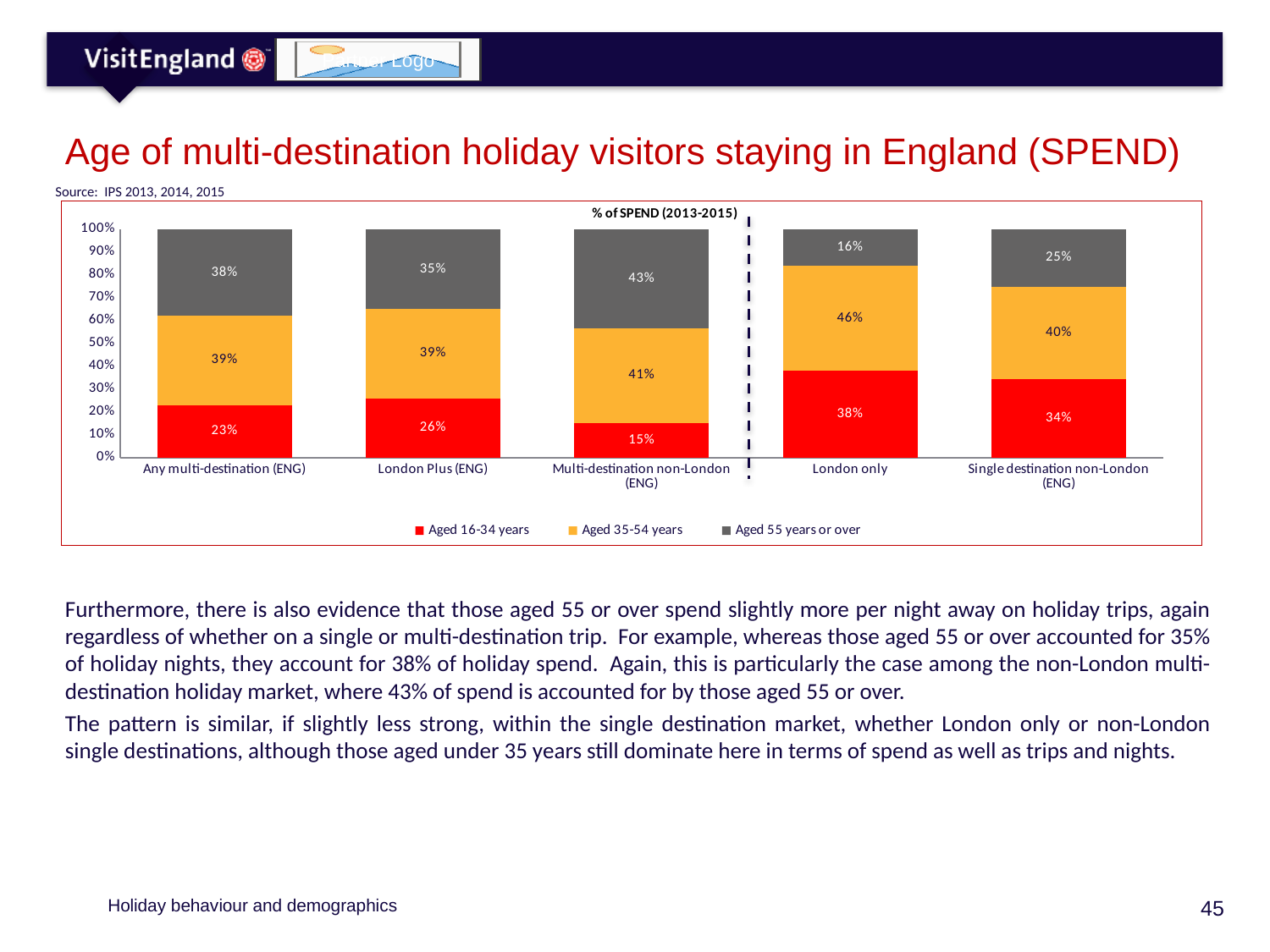
What share of spend for London Plus (ENG) is from visitors aged 35-54 years? 39% Which category has the lowest value for Aged 16-34 years? Multi-destination non-London (ENG) Which category has the highest value for Aged 55 years or over? Multi-destination non-London (ENG) What is the value for Aged 55 years or over in the Multi-destination non-London (ENG) bar? 43% How many categories are shown on the x axis? 5 What is the title shown above the chart? % of SPEND (2013-2015) What is the difference between the Aged 55 years or over values for Any multi-destination (ENG) and London only? 22% What kind of chart is shown on the slide? Stacked bar chart How many series does the legend list? 3 What percentage of spend for London only comes from visitors aged 16-34 years? 38% Which is larger: the Aged 35-54 years value for London only or for Single destination non-London (ENG)? London only Which colour represents Aged 16-34 years in the chart? Red